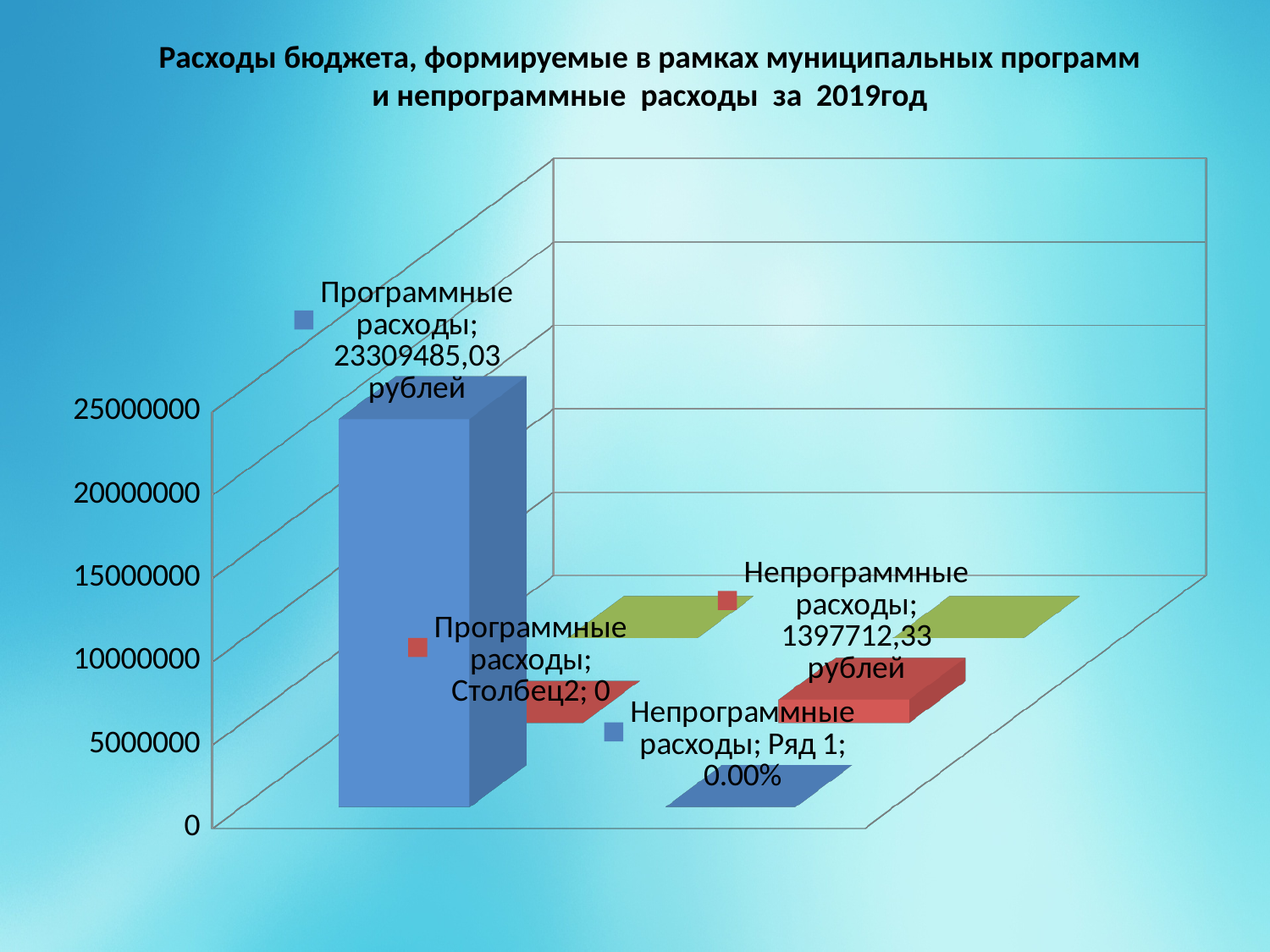
Is the value for Непрограммные расходы greater or less than 5000000? less What is the highest value shown on the vertical axis? 25000000 What year does the chart title refer to? 2019 Which category has the lowest value? Непрограммные расходы What is the value shown for Непрограммные расходы? 1397712,33 рублей What is the value shown for Программные расходы? 23309485,03 рублей Which is larger, Программные расходы or Непрограммные расходы? Программные расходы What kind of chart is shown on the slide? bar chart What is the difference between Программные расходы and Непрограммные расходы? 21911772,70 рублей Is the value for Программные расходы greater or less than 20000000? greater How many categories are shown on the chart? 2 Which category has the highest value? Программные расходы